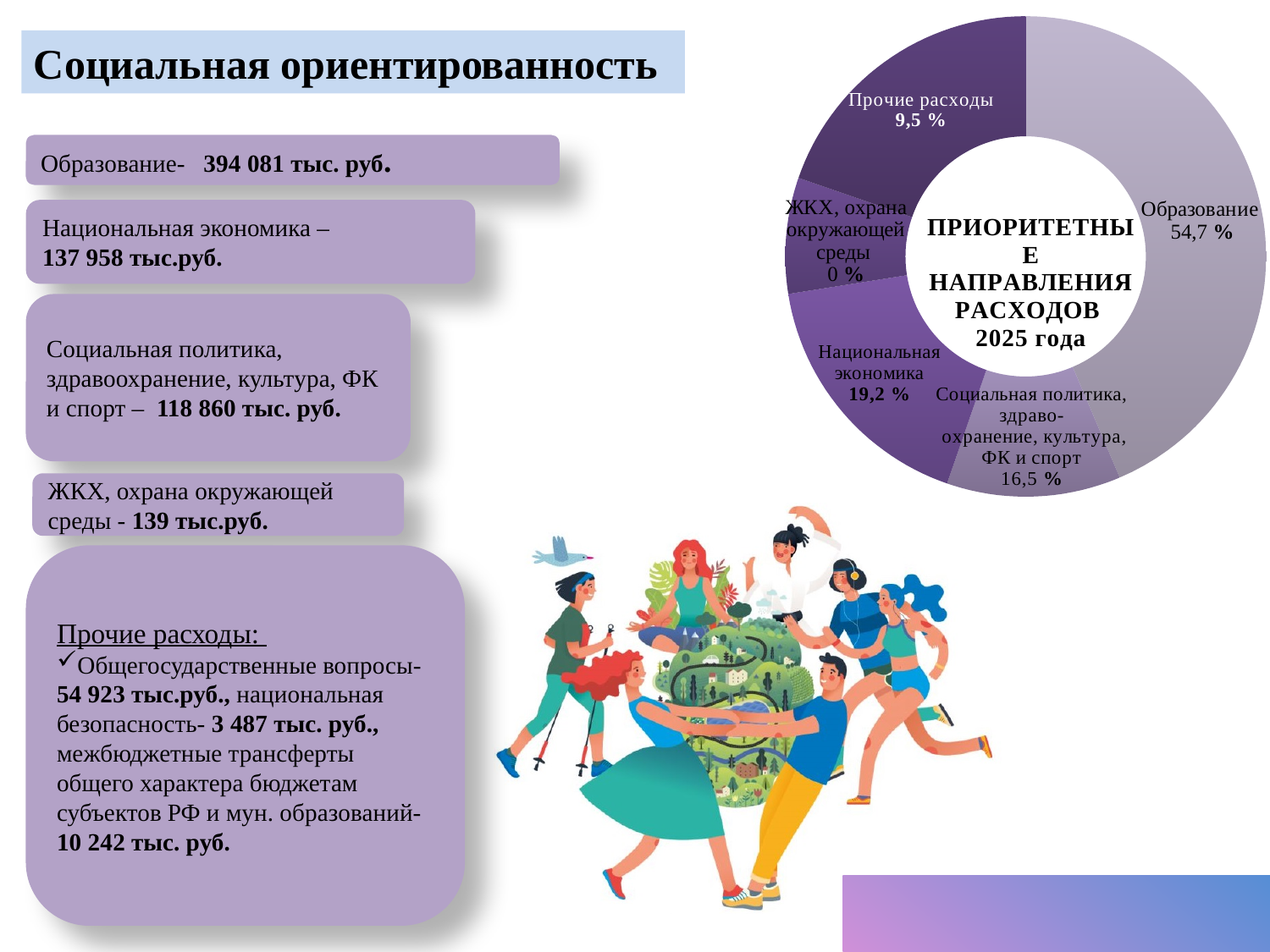
What share of expenditures does the chart show for Образование? 54,7 % What share does the chart show for ЖКХ, охрана окружающей среды? 0 % Which category has the largest share in the chart? Образование Which has a larger share: Национальная экономика or Прочие расходы? Национальная экономика Which category has the smallest share in the chart? ЖКХ, охрана окружающей среды What share does the chart show for Социальная политика, здравоохранение, культура, ФК и спорт? 16,5 % What is the title written in the centre of the chart? ПРИОРИТЕТНЫЕ НАПРАВЛЕНИЯ РАСХОДОВ 2025 года What share of expenditures does the chart show for Национальная экономика? 19,2 % How many categories are shown in the chart? 5 What type of chart is shown on the slide? Doughnut (pie) chart What is the difference in percentage points between the shares of Образование and Национальная экономика? 35,5 What share does the chart show for Прочие расходы? 9,5 %